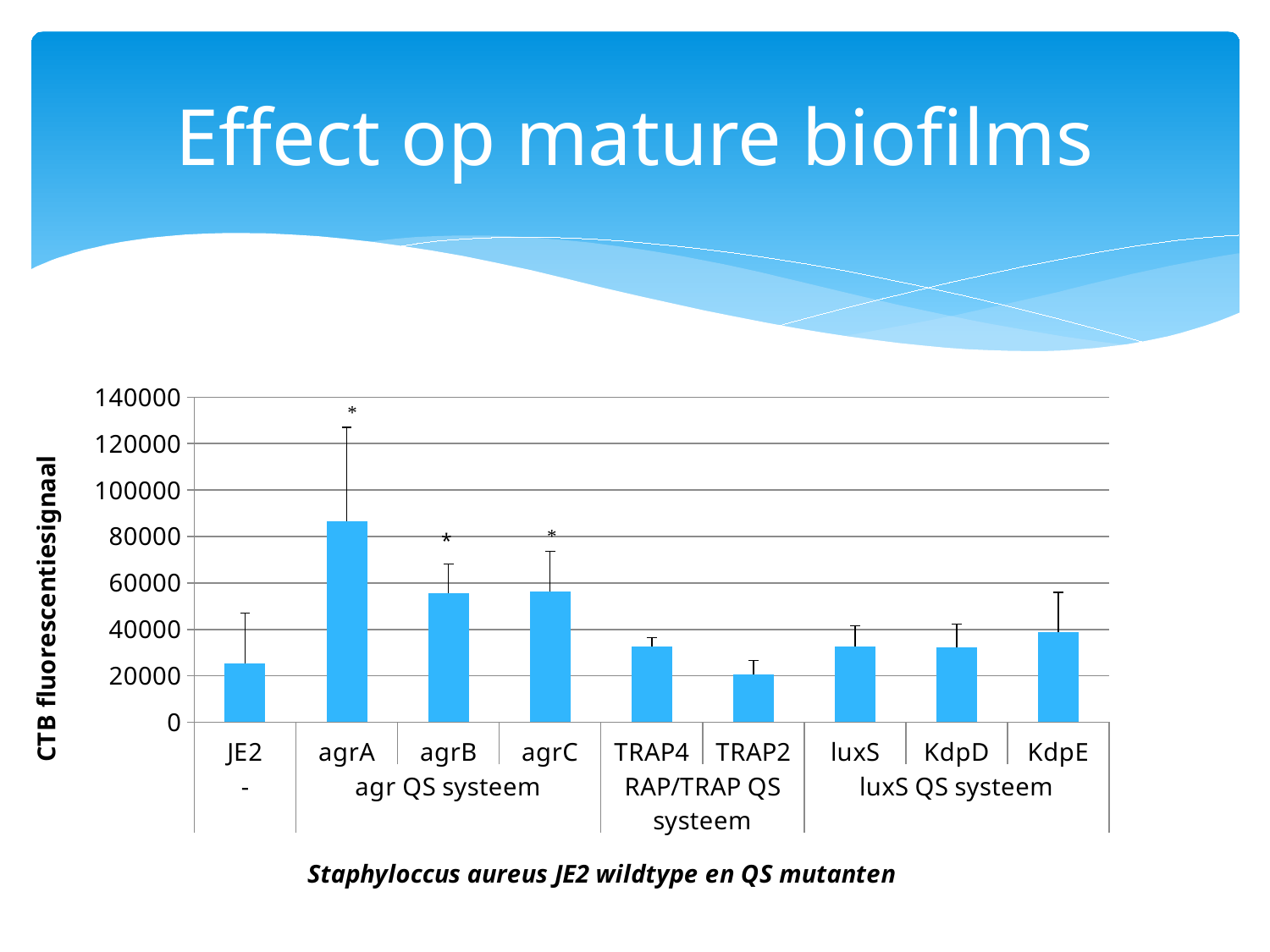
Is the value for KdpE greater or less than 60000? less Which strain has the highest CTB fluorescentiesignaal? agrA Which strain has the lowest CTB fluorescentiesignaal? TRAP2 Is the value for agrA greater or less than 80000? greater Is the value for TRAP2 greater or less than 40000? less How many strains (bars) are plotted in the chart? 9 Which has a larger CTB fluorescentiesignaal, agrA or JE2? agrA What kind of chart is shown on the slide? bar chart Which QS system group contains the strains TRAP4 and TRAP2? RAP/TRAP QS systeem What is the label of the y axis? CTB fluorescentiesignaal